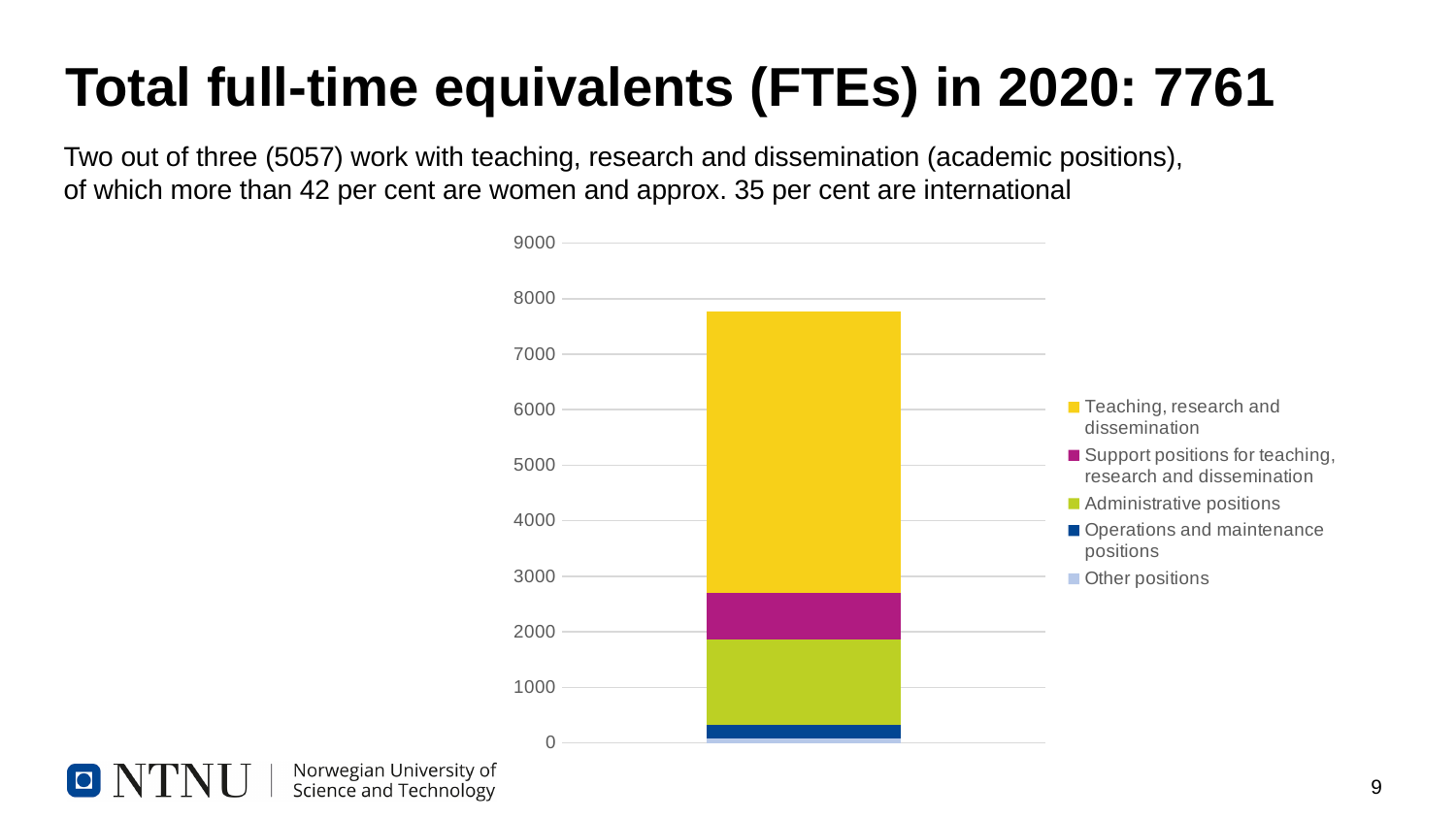
Which series forms the smallest segment of the stacked bar? Other positions What colour represents Teaching, research and dissemination in the chart? Yellow Which segment is larger: Administrative positions or Support positions for teaching, research and dissemination? Administrative positions Is the value for Administrative positions greater or less than 1000? greater Is the value for Operations and maintenance positions greater or less than 1000? less Which series forms the largest segment of the stacked bar? Teaching, research and dissemination How many series does the legend list? 5 What kind of chart is shown on the slide? Stacked bar chart How many bars are plotted in the chart? 1 Is the total height of the stacked bar greater or less than 7000? greater According to the slide, what is the total number of FTEs represented by the stacked bar? 7761